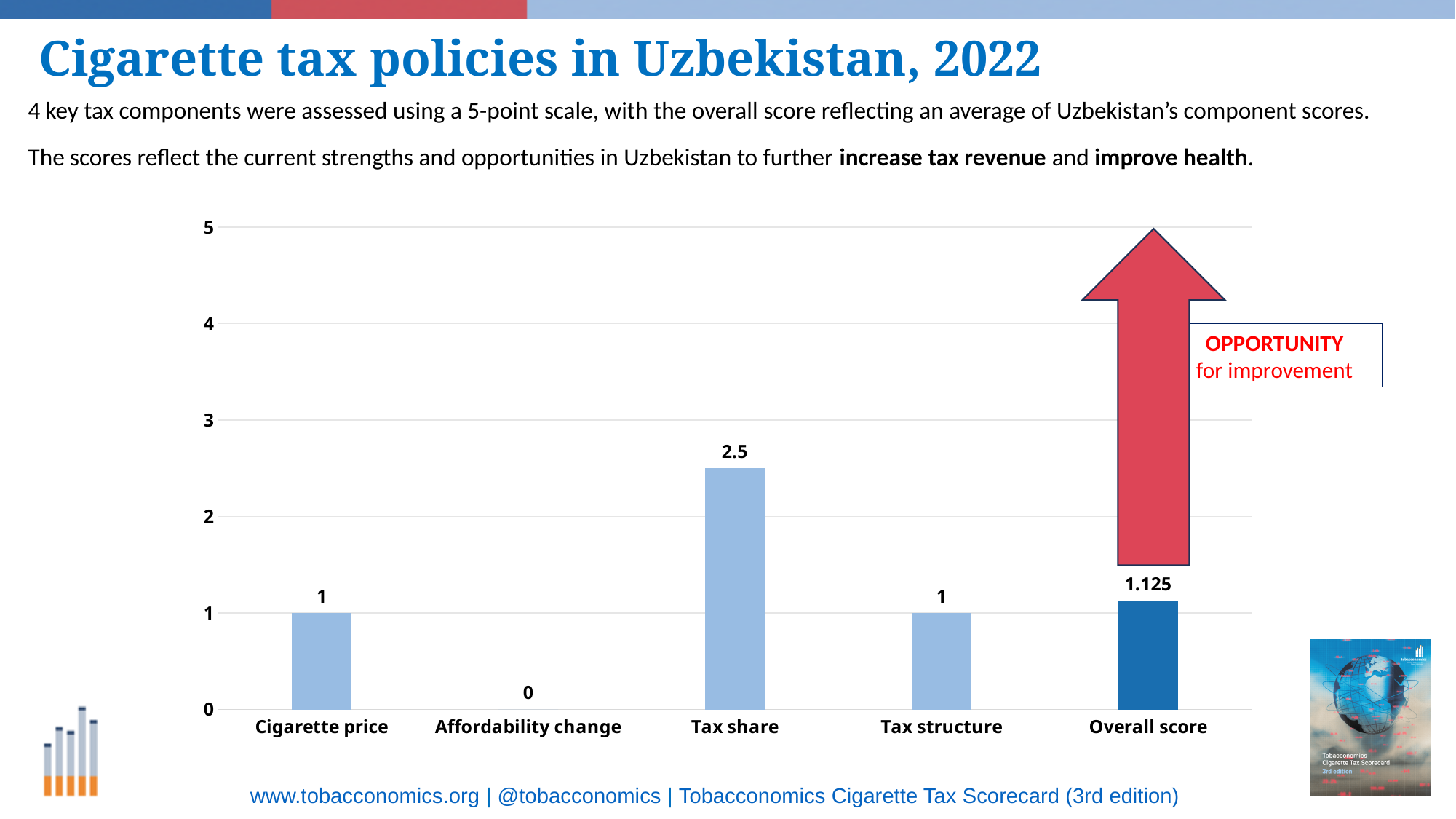
What is the score for Affordability change? 0 What is the difference between the Tax share score and the Tax structure score? 1.5 What is the Overall score shown on the chart? 1.125 What is the score for Tax share? 2.5 Which is larger, the score for Tax share or the Overall score? Tax share What is the maximum value shown on the y axis? 5 What kind of chart is shown on the slide? Bar chart Which category has the highest score? Tax share Is the score for Tax share greater or less than 2? greater How many categories are shown on the x axis? 5 What is the score for Cigarette price? 1 Which category has the lowest score? Affordability change